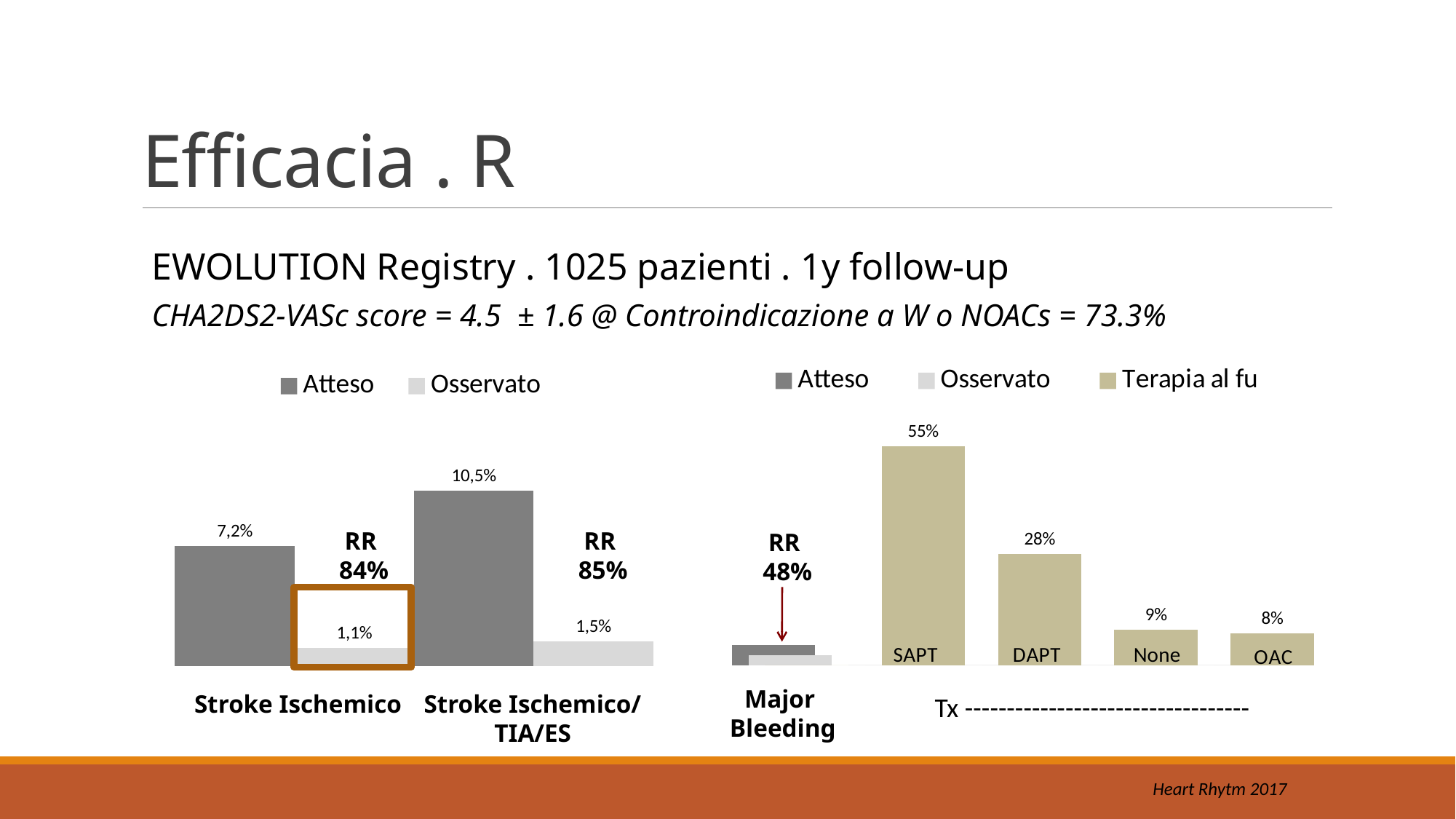
What kind of chart is the right chart? Bar chart In the left chart, what is the difference between the Atteso and Osservato values for Stroke Ischemico/TIA/ES? 9,0% In the left chart, which is larger for Stroke Ischemico: Atteso or Osservato? Atteso In the right chart, what is the value for SAPT? 55% In the right chart, what is the value for DAPT? 28% In the right chart, which Terapia al fu category has the lowest value? OAC In the left chart, what is the Atteso value for Stroke Ischemico/TIA/ES? 10,5% In the left chart, what is the Osservato value for Stroke Ischemico? 1,1% How many series does the legend of the left chart list? 2 In the left chart, what is the Osservato value for Stroke Ischemico/TIA/ES? 1,5% In the left chart, what is the Atteso value for Stroke Ischemico? 7,2% In the right chart, what is the difference between the SAPT and DAPT values? 27%